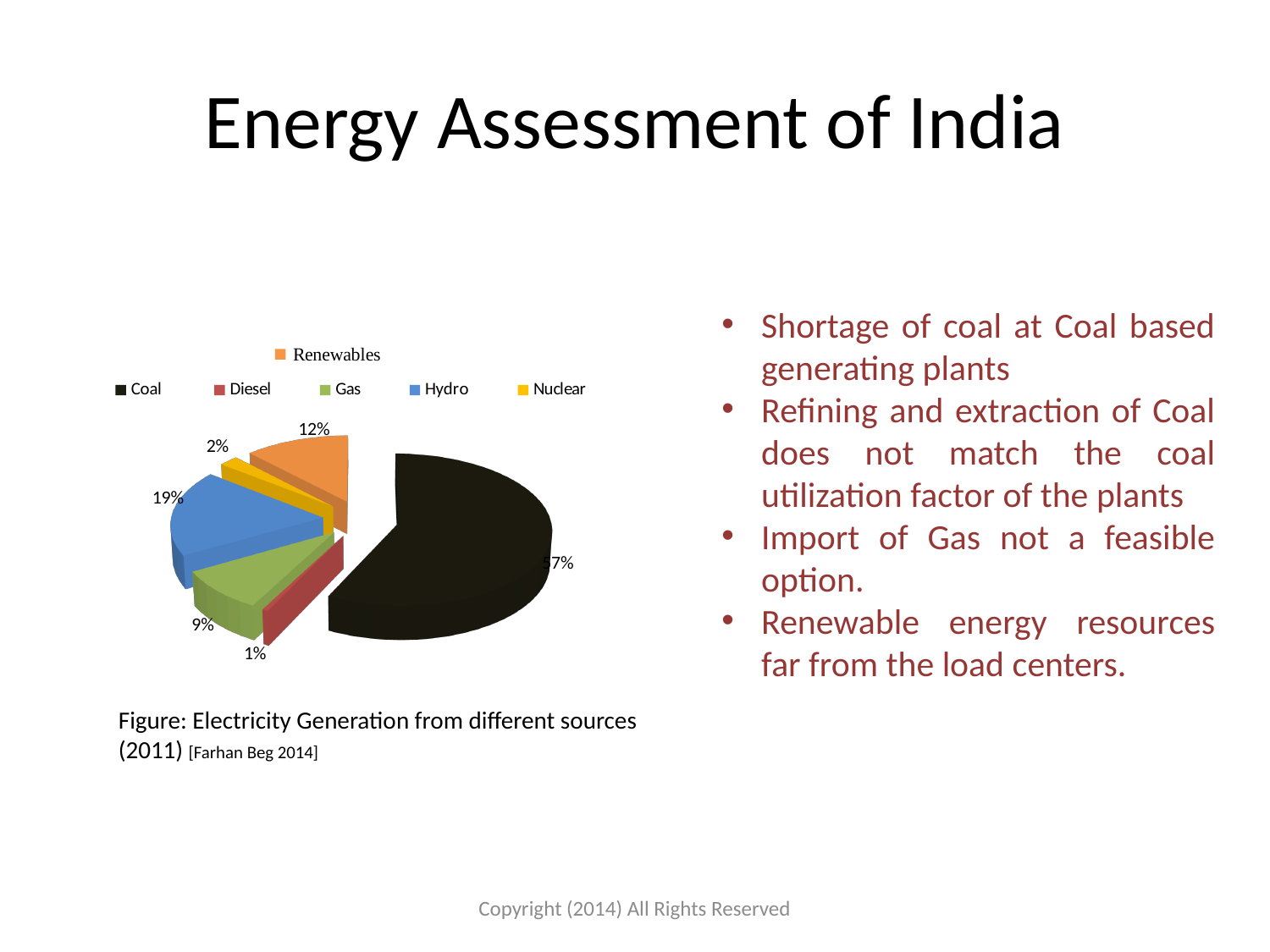
What percentage is shown for Renewables in the pie chart? 12% What kind of chart is shown on the slide? pie chart What share of electricity generation does Hydro account for in the pie chart? 19% Which is larger in the pie chart, the Renewables share or the Hydro share? Hydro How many percentage points larger is the Hydro share than the Gas share? 10% What percentage is shown for Diesel in the pie chart? 1% What percentage is shown for Nuclear in the pie chart? 2% How many sources are listed in the pie chart's legend? 6 According to the caption, what year does the electricity generation figure refer to? 2011 Which source has the smallest slice of the pie chart? Diesel What percentage is shown for Gas in the pie chart? 9% Which source has the largest slice of the pie chart? Coal